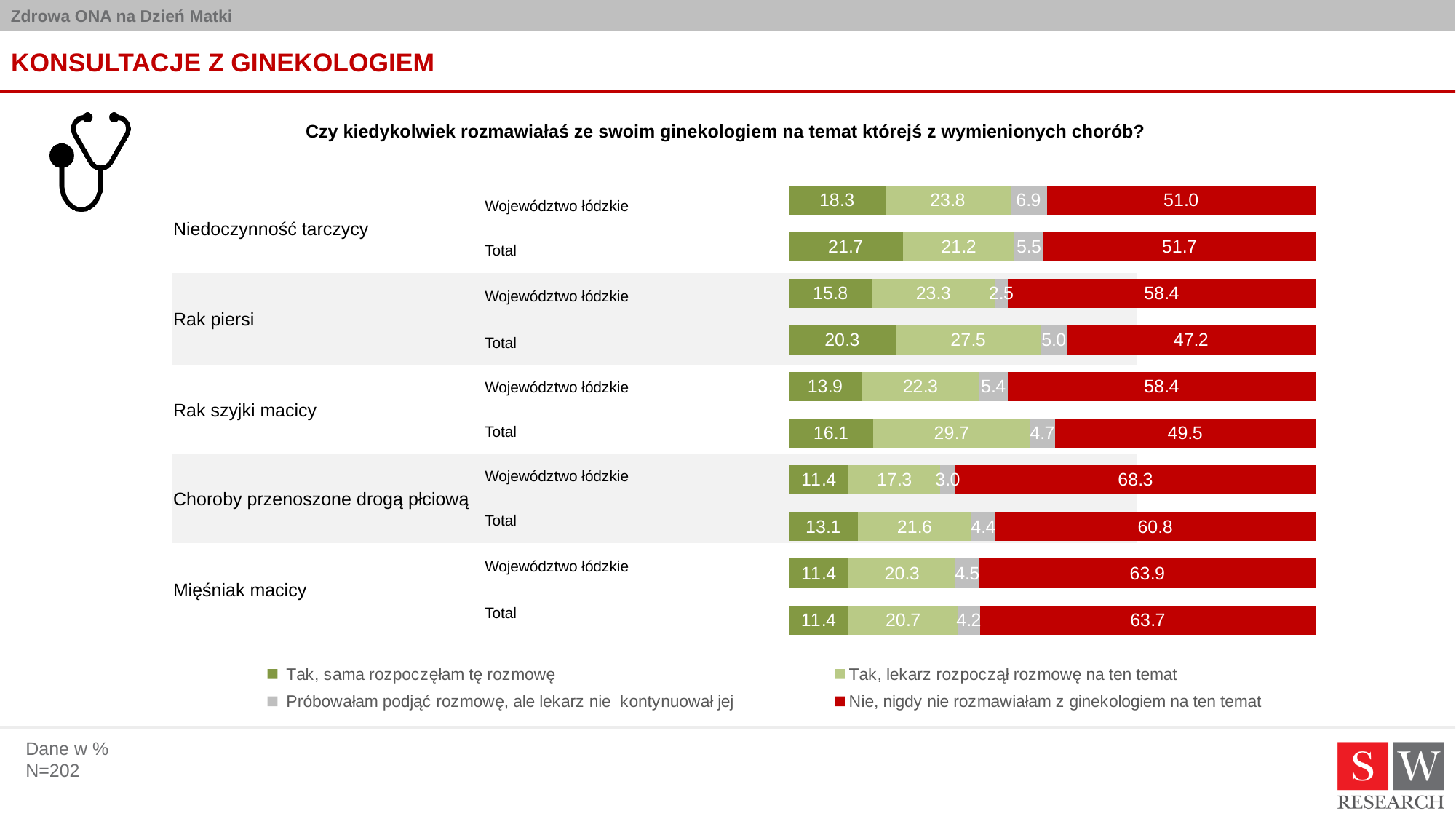
For Rak piersi (Total), what is the value for 'Tak, lekarz rozpoczął rozmowę na ten temat'? 27.5 How many diseases are shown on the chart? 5 For Mięśniak macicy (Total), what is the value for 'Nie, nigdy nie rozmawiałam z ginekologiem na ten temat'? 63.7 What colour represents 'Nie, nigdy nie rozmawiałam z ginekologiem na ten temat'? Red For Rak piersi, what is the difference between the Województwo łódzkie and Total values for 'Nie, nigdy nie rozmawiałam z ginekologiem na ten temat'? 11.2 What kind of chart is shown on the slide? Stacked bar chart For Choroby przenoszone drogą płciową, what is the difference between the Total and Województwo łódzkie values for 'Tak, lekarz rozpoczął rozmowę na ten temat'? 4.3 How many series does the legend list? 4 For Niedoczynność tarczycy in Województwo łódzkie, what is the value for 'Nie, nigdy nie rozmawiałam z ginekologiem na ten temat'? 51.0 For Rak szyjki macicy, which has the larger value for 'Tak, lekarz rozpoczął rozmowę na ten temat': Województwo łódzkie or Total? Total Which bar has the highest value for 'Nie, nigdy nie rozmawiałam z ginekologiem na ten temat'? Choroby przenoszone drogą płciową, Województwo łódzkie Which bar has the lowest value for 'Próbowałam podjąć rozmowę, ale lekarz nie kontynuował jej'? Rak piersi, Województwo łódzkie